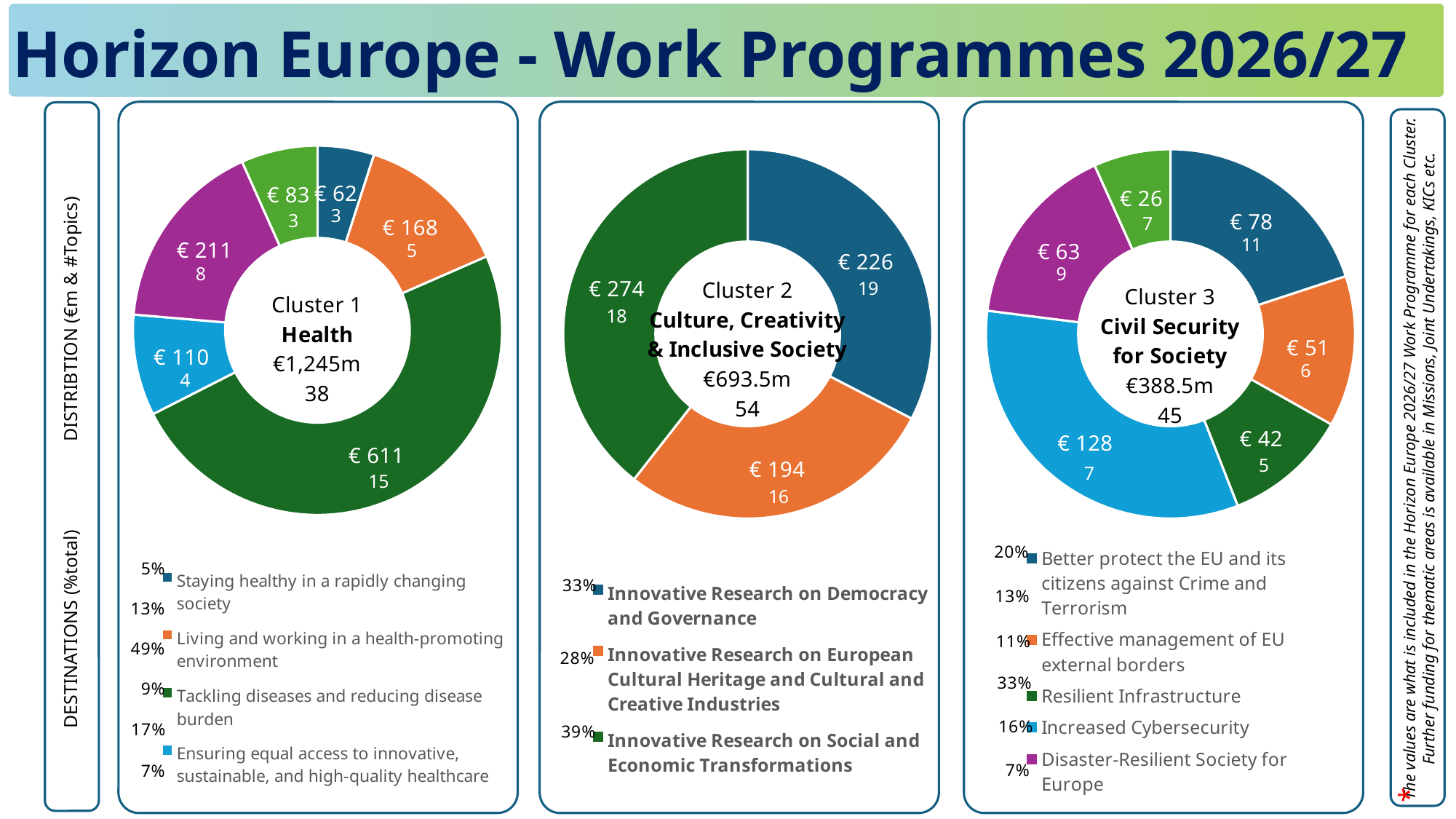
In the Cluster 2 Culture, Creativity & Inclusive Society chart, what is the value for Innovative Research on Democracy and Governance? € 226 In the Cluster 2 chart, what share of the total does Innovative Research on Social and Economic Transformations represent? 39% In the Cluster 1 Health chart, what is the smallest segment's value? € 62 What is the total budget shown in the centre of the Cluster 3 Civil Security for Society chart? €388.5m In the Cluster 2 chart, what is the difference between the € 274 segment and the € 194 segment? € 80 What is the total budget shown in the centre of the Cluster 1 Health chart? €1,245m In the Cluster 3 Civil Security for Society chart, what is the value for Increased Cybersecurity? € 128 What kind of chart is used for Cluster 1 Health? Donut (pie) chart How many topics are shown in the centre of the Cluster 2 chart? 54 In the Cluster 1 Health chart, what is the largest segment's value? € 611 How many segments does the Cluster 1 Health chart have? 6 In the Cluster 3 chart, which is larger: the Better protect the EU segment or the Effective management of EU external borders segment? Better protect the EU and its citizens against Crime and Terrorism